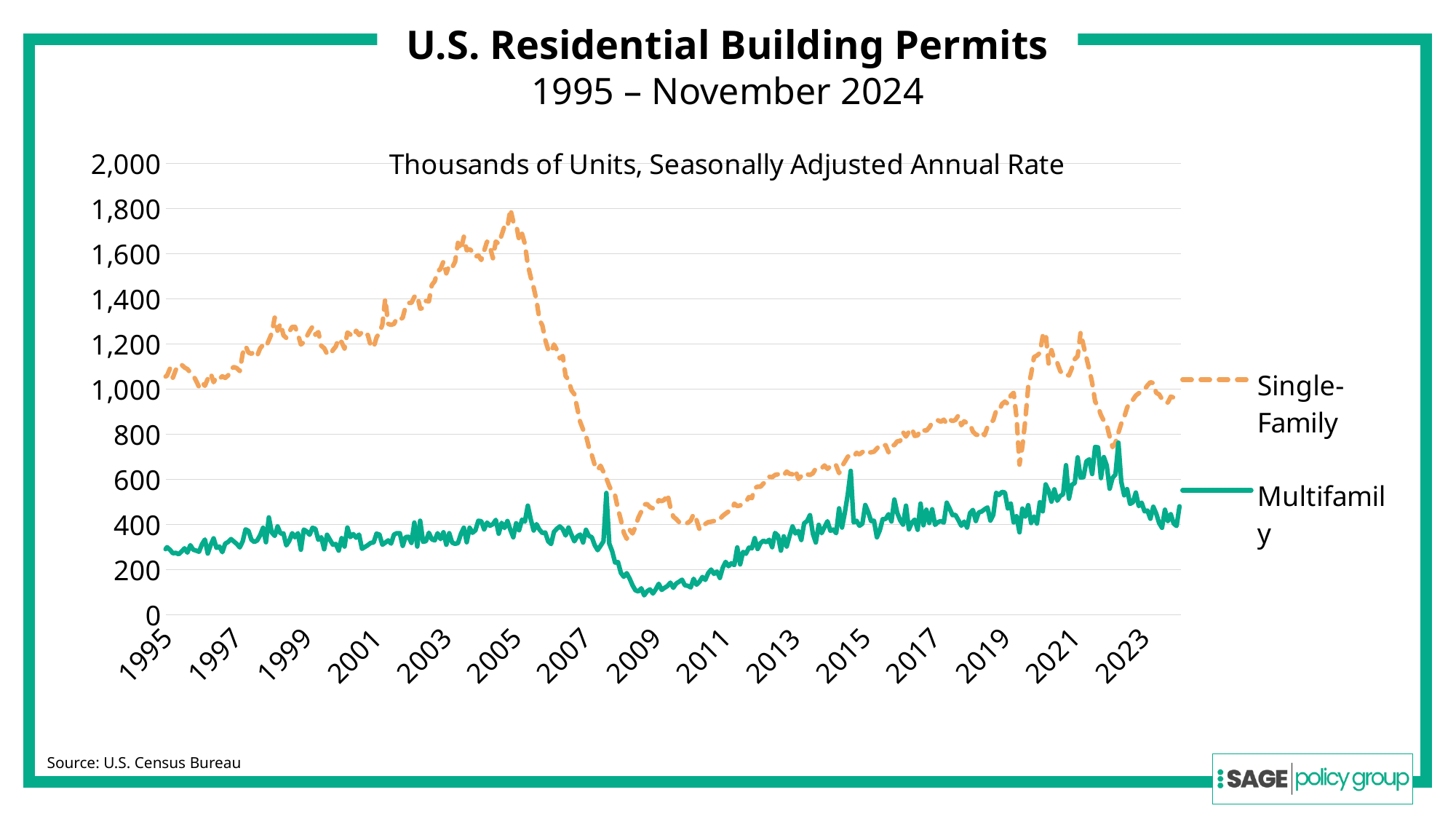
Does the Single-Family series rise or fall between 2005 and 2009? Fall What kind of chart is shown on the slide? Line chart Is the value of the Multifamily series at its low point around 2009 greater or less than 200? less Is the value of the Single-Family series around 2009 greater or less than 600? less Around 2005, which series has the larger value, Single-Family or Multifamily? Single-Family How many series does the legend list? 2 Is the highest value of the Multifamily series around 2022 greater or less than 600? greater What is the title of the chart? U.S. Residential Building Permits What is the source cited for the chart data? U.S. Census Bureau Which series reaches the highest value anywhere on the chart, Single-Family or Multifamily? Single-Family